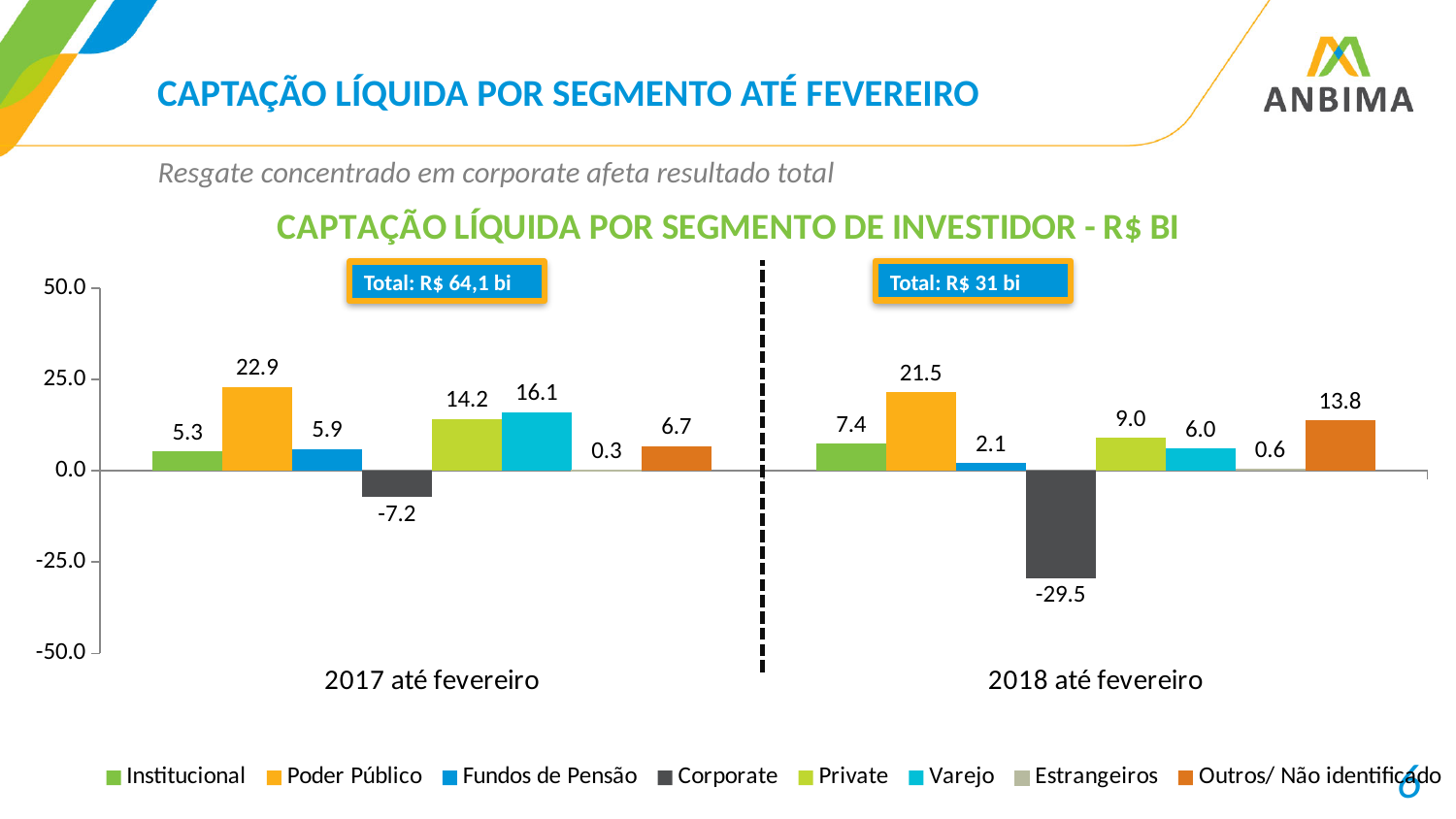
What is the difference between the Corporate values for 2017 até fevereiro and 2018 até fevereiro? 22.3 How many period groups are shown on the x axis? 2 How many series does the legend list? 8 Which is larger, the Private value in 2017 até fevereiro or in 2018 até fevereiro? 2017 até fevereiro What is the value for Poder Público in 2017 até fevereiro? 22.9 What total is shown in the box above the 2018 até fevereiro group? Total: R$ 31 bi What is the value for Varejo in 2017 até fevereiro? 16.1 What kind of chart is shown on the slide? Bar chart Which segment has the lowest value in 2017 até fevereiro? Corporate Which segment has the highest value in 2018 até fevereiro? Poder Público What is the title of the chart? CAPTAÇÃO LÍQUIDA POR SEGMENTO DE INVESTIDOR - R$ BI What is the value for Corporate in 2018 até fevereiro? -29.5